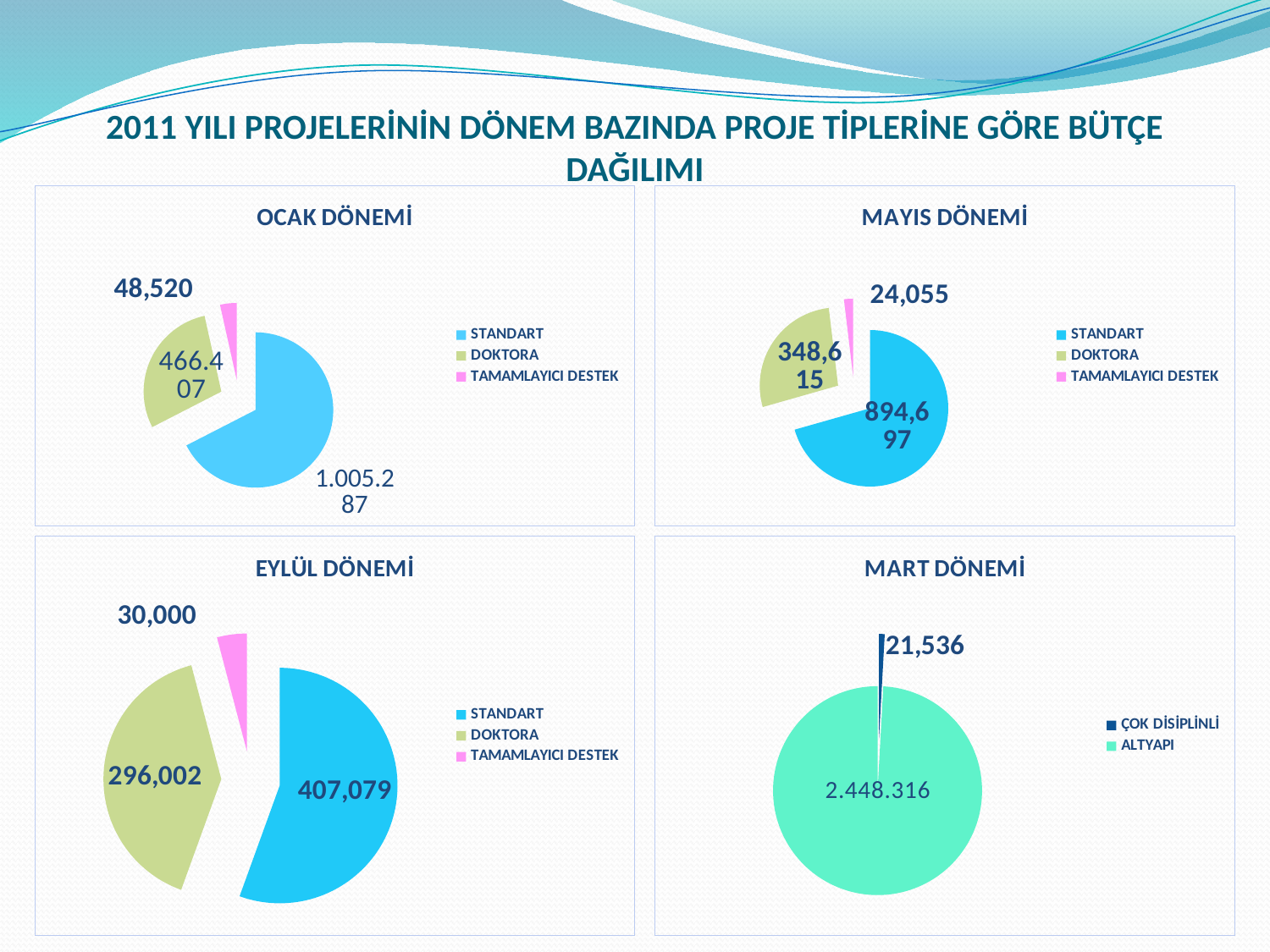
In the MAYIS DÖNEMİ chart, which category has the largest slice? STANDART In the OCAK DÖNEMİ chart, what is the value for TAMAMLAYICI DESTEK? 48,520 In the MAYIS DÖNEMİ chart, what is the difference between the STANDART and DOKTORA values? 546,082 In the MAYIS DÖNEMİ chart, what is the value for DOKTORA? 348,615 How many entries does the legend of the EYLÜL DÖNEMİ chart list? 3 In the MART DÖNEMİ chart, what is the value for ÇOK DİSİPLİNLİ? 21,536 In the OCAK DÖNEMİ chart, what is the value for STANDART? 1.005.287 How many categories does the MART DÖNEMİ chart show? 2 In the EYLÜL DÖNEMİ chart, what is the difference between the STANDART and DOKTORA values? 111,077 In the EYLÜL DÖNEMİ chart, which category has the smallest slice? TAMAMLAYICI DESTEK In the MART DÖNEMİ chart, which is larger, ÇOK DİSİPLİNLİ or ALTYAPI? ALTYAPI What type of chart is the OCAK DÖNEMİ chart? Pie chart